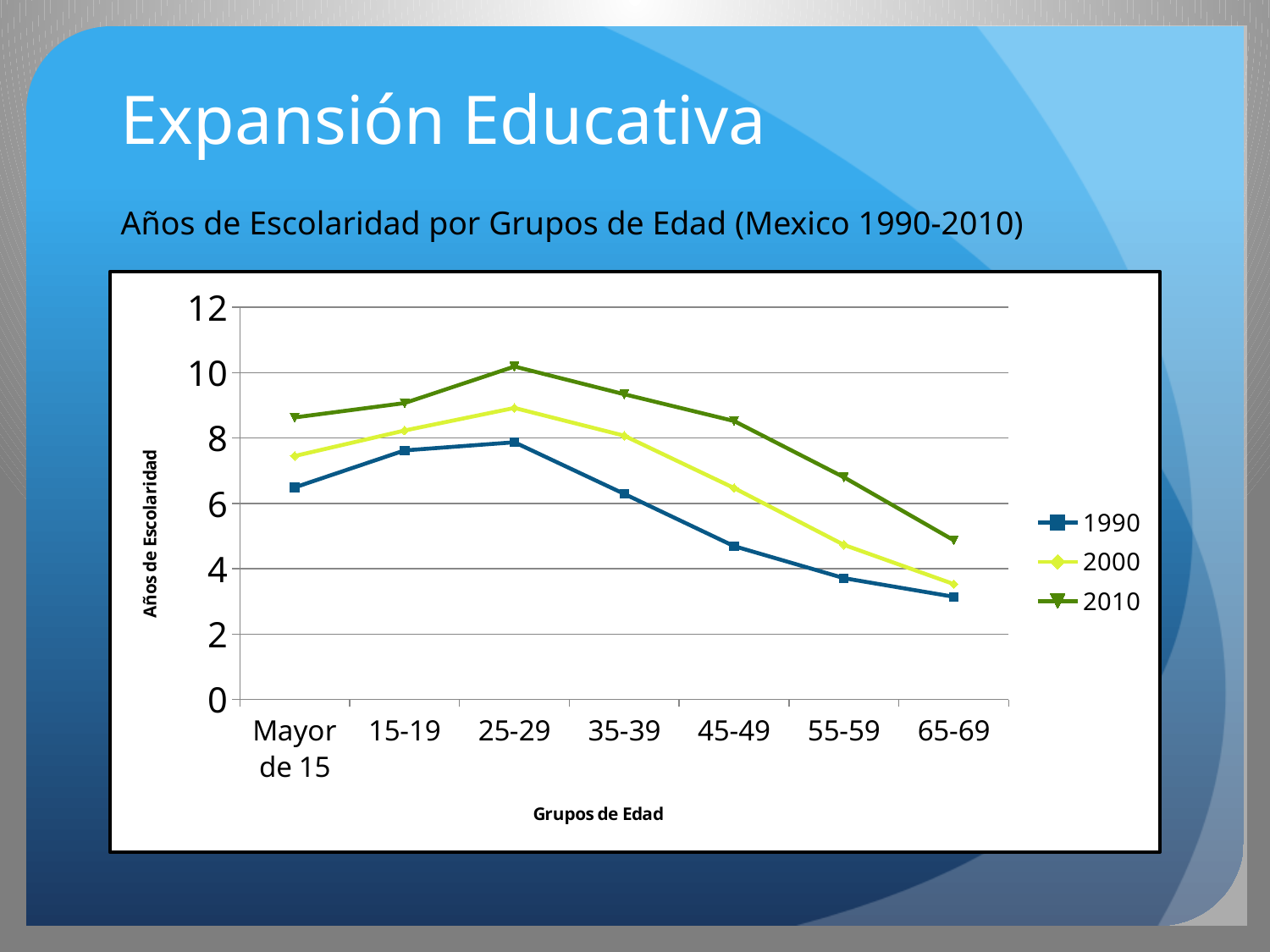
For the 2010 series, which age group has the highest value? 25-29 What is the title of the vertical axis? Años de Escolaridad What kind of chart is shown on the slide? line chart Is the 2010 value for the 65-69 age group greater or less than 6? less How many age groups are shown on the x axis? 7 Is the 2010 value for the 25-29 age group greater or less than 8? greater For the 1990 series, which age group has the lowest value? 65-69 For the 45-49 age group, which series has the larger value, 1990 or 2010? 2010 Is the 2000 value for the 45-49 age group greater or less than 6? greater How many series does the legend list? 3 Do the 1990 values rise or fall from the 25-29 age group to the 65-69 age group? fall